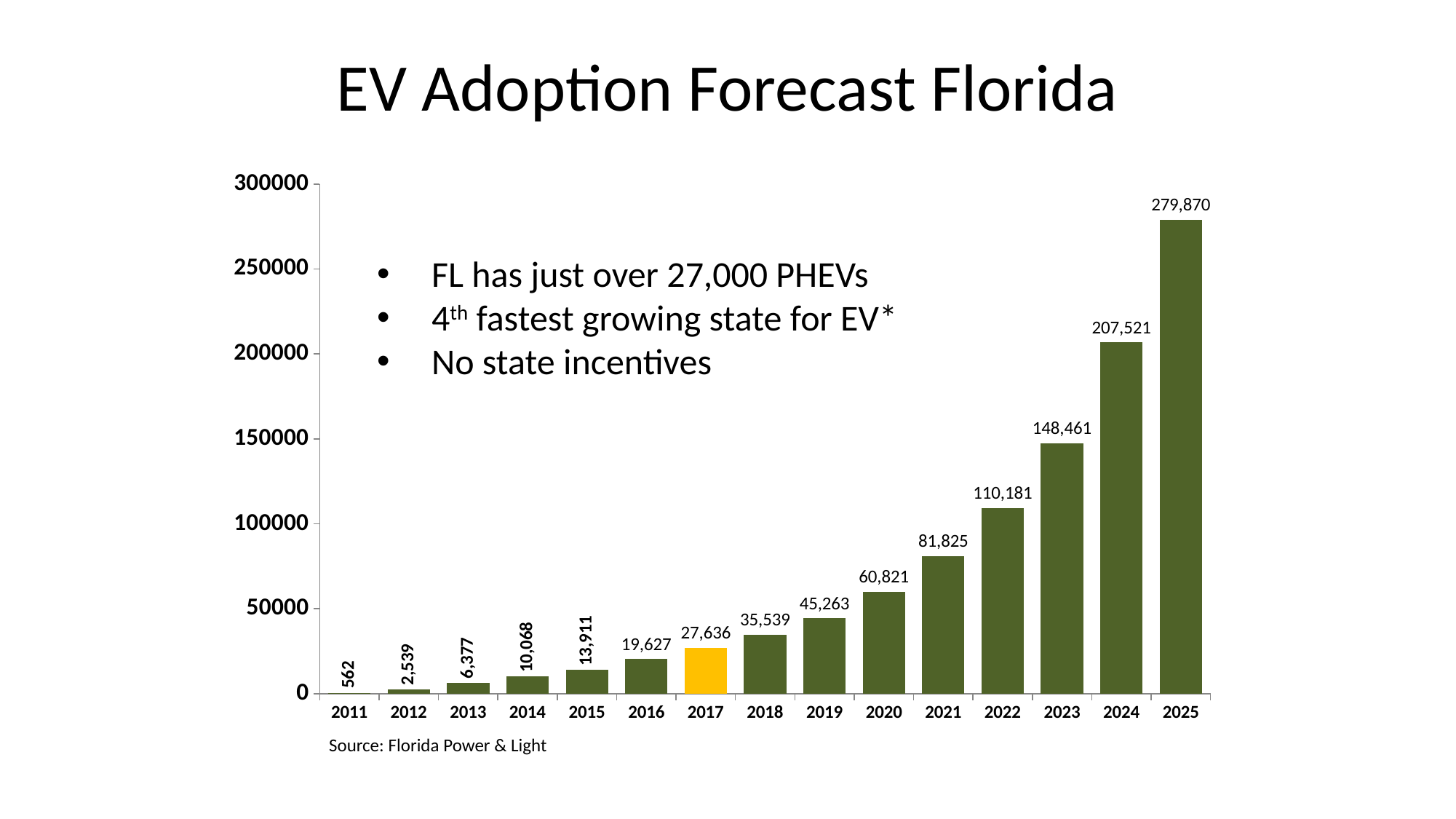
What is the value shown for 2017? 27,636 What is the value shown for 2011? 562 How many years are shown on the x axis? 15 Is the value for 2023 greater or less than 100000? greater Which is larger, the value for 2019 or the value for 2018? 2019 What is the difference between the values for 2025 and 2024? 72,349 What is the forecast value for 2025? 279,870 Which year has the lowest value? 2011 What kind of chart is this? bar chart Do the values rise or fall from 2011 to 2025? rise Which year has the highest value? 2025 What is the value shown for 2020? 60,821